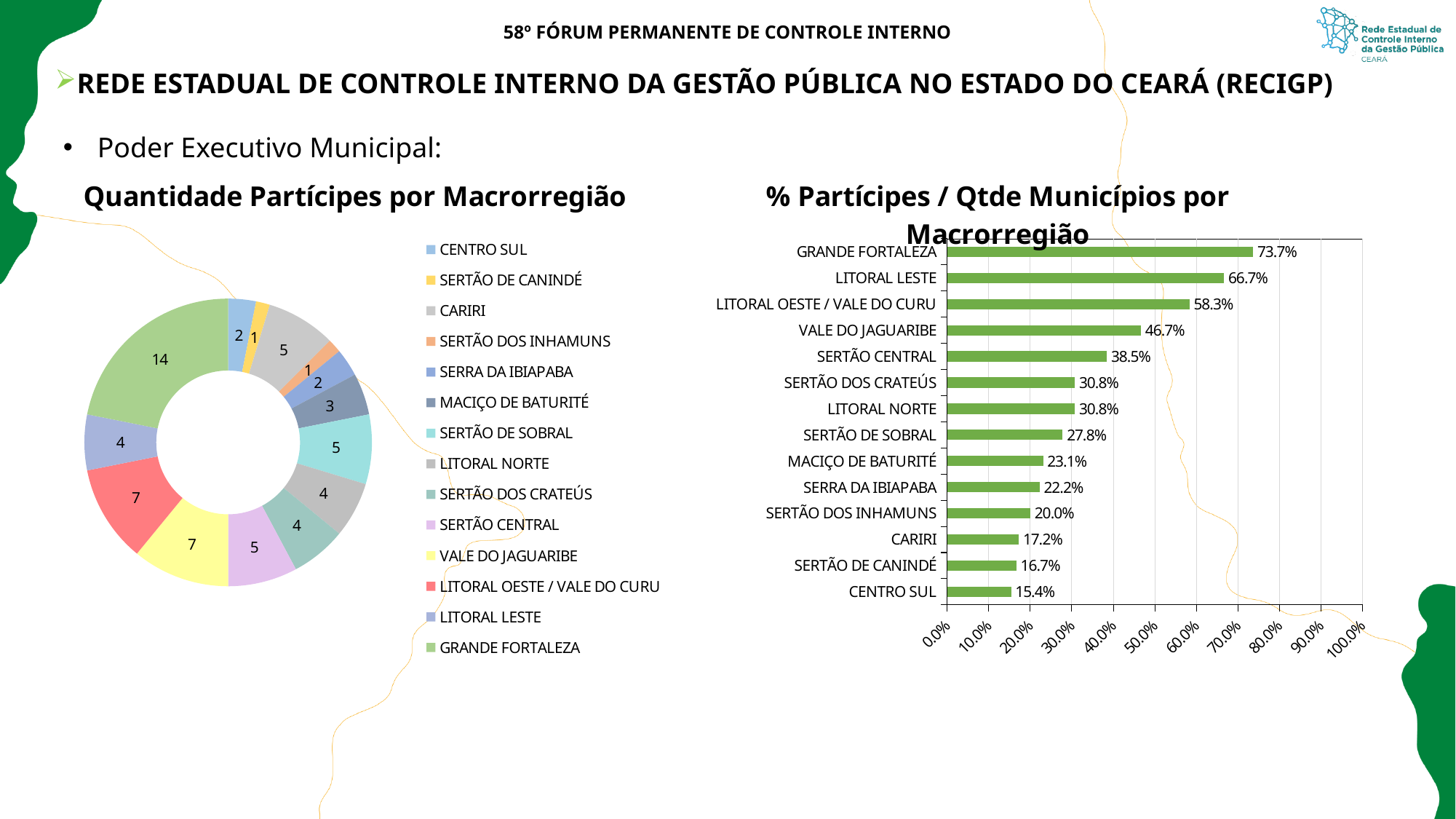
In the chart 'Quantidade Partícipes por Macrorregião', which macrorregião has the highest value? GRANDE FORTALEZA In the chart 'Quantidade Partícipes por Macrorregião', what is the value for GRANDE FORTALEZA? 14 In the chart '% Partícipes / Qtde Municípios por Macrorregião', what is the value for SERTÃO DOS INHAMUNS? 20.0% In the chart 'Quantidade Partícipes por Macrorregião', how many categories does the legend list? 14 What kind of chart is '% Partícipes / Qtde Municípios por Macrorregião'? Bar chart In the chart 'Quantidade Partícipes por Macrorregião', what is the value for MACIÇO DE BATURITÉ? 3 In the chart '% Partícipes / Qtde Municípios por Macrorregião', what is the difference between GRANDE FORTALEZA and CENTRO SUL? 58.3% In the chart '% Partícipes / Qtde Municípios por Macrorregião', which is larger: VALE DO JAGUARIBE or SERTÃO CENTRAL? VALE DO JAGUARIBE What kind of chart is 'Quantidade Partícipes por Macrorregião'? Doughnut chart In the chart 'Quantidade Partícipes por Macrorregião', what is the difference between the values for GRANDE FORTALEZA and VALE DO JAGUARIBE? 7 In the chart '% Partícipes / Qtde Municípios por Macrorregião', which macrorregião has the lowest value? CENTRO SUL In the chart '% Partícipes / Qtde Municípios por Macrorregião', what is the value for LITORAL LESTE? 66.7%